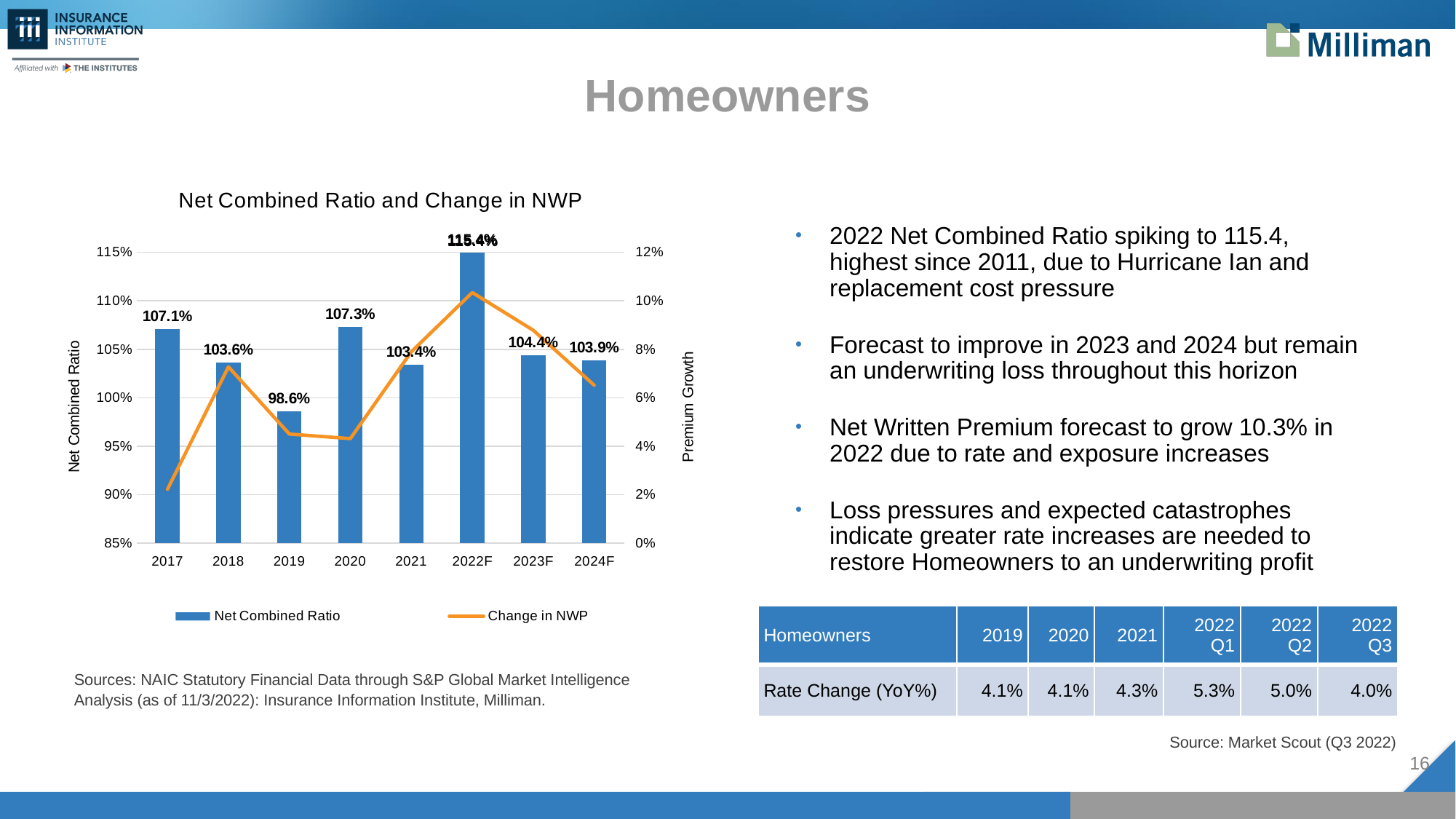
Which year has the highest Net Combined Ratio? 2022F What is the title of the chart? Net Combined Ratio and Change in NWP What is the Net Combined Ratio for 2024F? 103.9% What is the difference between the Net Combined Ratio in 2022F and in 2023F? 11.0% Is the Change in NWP for 2017 greater or less than 4%? less Which is larger, the Net Combined Ratio in 2017 or in 2020? 2020 Is the Change in NWP for 2022F greater or less than 8%? greater How many series does the chart legend list? 2 How many years are shown on the x axis of the chart? 8 What is the Net Combined Ratio for 2022F? 115.4% What is the Net Combined Ratio for 2019? 98.6% Which year has the lowest Net Combined Ratio? 2019